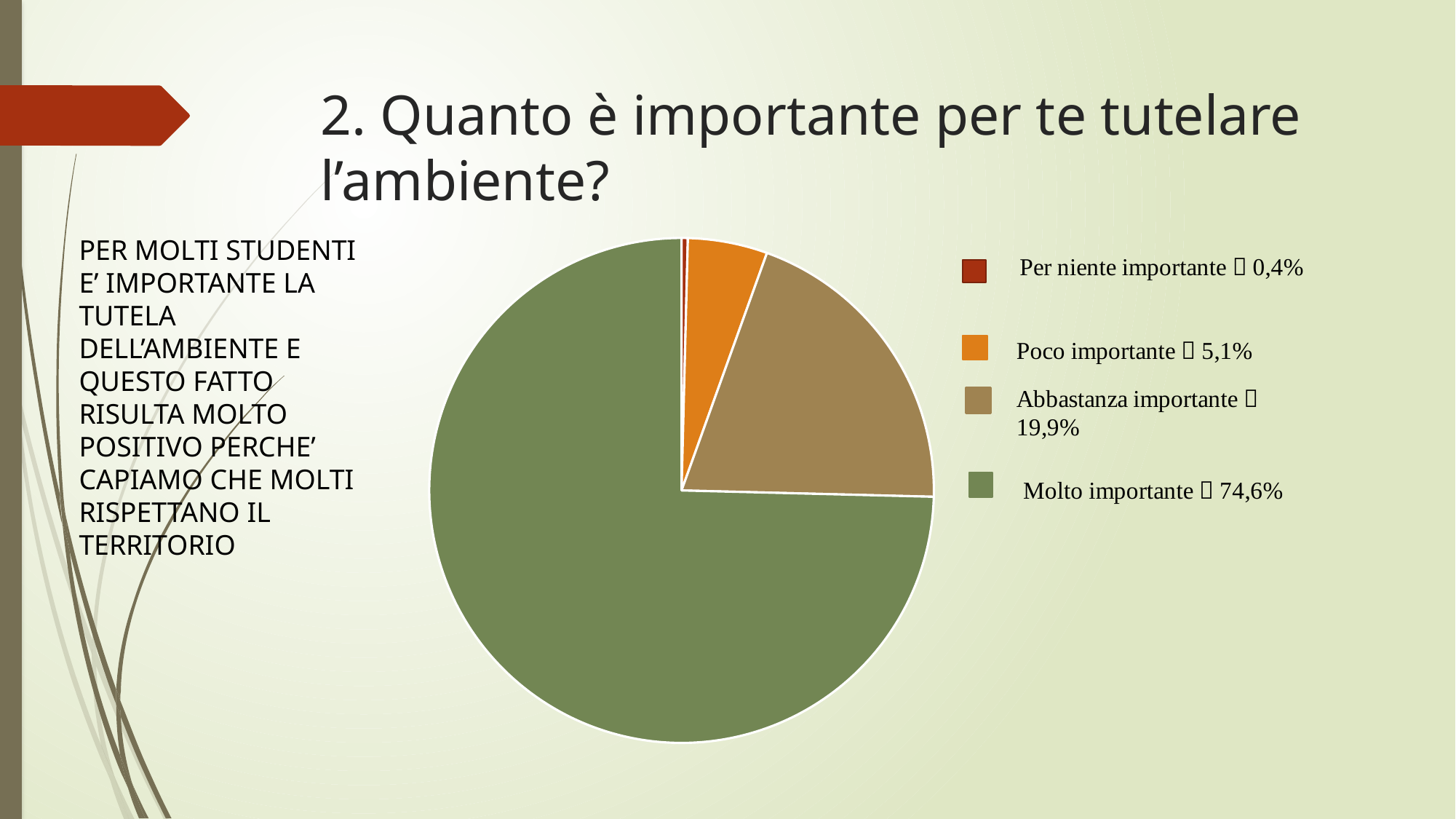
What is the title of the slide containing the pie chart? 2. Quanto è importante per te tutelare l'ambiente? What percentage of respondents answered "Per niente importante"? 0,4% Which response has the largest share of the pie? Molto importante What percentage of respondents answered "Molto importante"? 74,6% What colour is the slice for "Poco importante"? orange How many slices does the pie chart have? 4 Which is larger, the share for "Abbastanza importante" or the share for "Poco importante"? Abbastanza importante Which response has the smallest share of the pie? Per niente importante What is the difference in percentage points between "Molto importante" and "Abbastanza importante"? 54,7 What kind of chart is shown on the slide? pie chart What percentage of respondents answered "Abbastanza importante"? 19,9% What percentage of respondents answered "Poco importante"? 5,1%